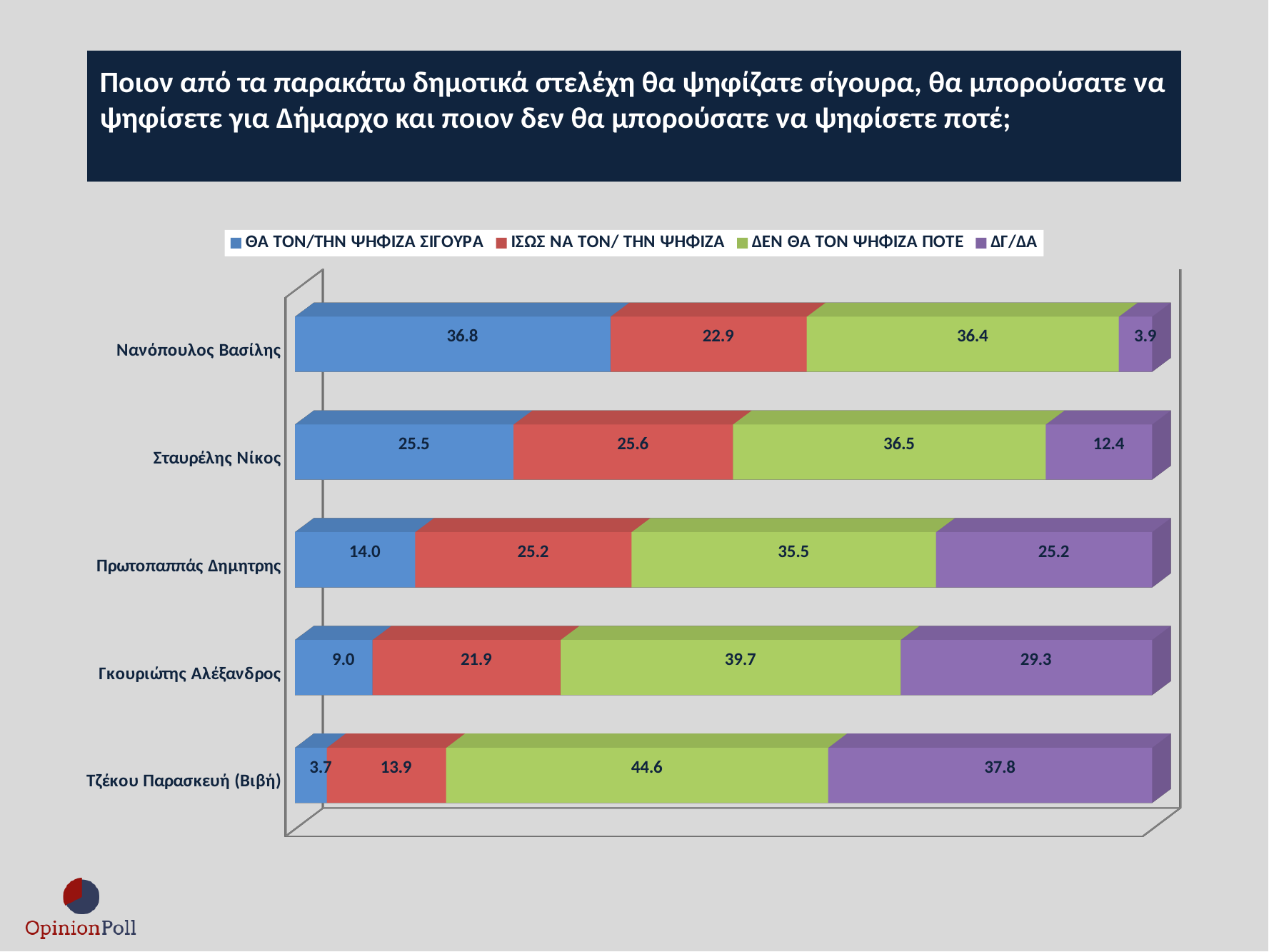
Who has the larger ΔΓ/ΔΑ value, Γκουριώτης Αλέξανδρος or Πρωτοπαππάς Δημήτρης? Γκουριώτης Αλέξανδρος What is the total of the stacked bar for Σταυρέλης Νίκος? 100.0 What is the value of ΘΑ ΤΟΝ/ΤΗΝ ΨΗΦΙΖΑ ΣΙΓΟΥΡΑ for Νανόπουλος Βασίλης? 36.8 Which candidate has the highest ΔΕΝ ΘΑ ΤΟΝ ΨΗΦΙΖΑ ΠΟΤΕ value? Τζέκου Παρασκευή (Βιβή) Which candidate has the lowest ΔΓ/ΔΑ value? Νανόπουλος Βασίλης What is the ΔΓ/ΔΑ value for Τζέκου Παρασκευή (Βιβή)? 37.8 What type of chart is shown on the slide? Stacked bar chart What is the difference between the ΘΑ ΤΟΝ/ΤΗΝ ΨΗΦΙΖΑ ΣΙΓΟΥΡΑ values of Νανόπουλος Βασίλης and Σταυρέλης Νίκος? 11.3 How many series does the legend list? 4 Which candidate has the highest ΘΑ ΤΟΝ/ΤΗΝ ΨΗΦΙΖΑ ΣΙΓΟΥΡΑ value? Νανόπουλος Βασίλης How many candidates are shown in the chart? 5 What is the ΙΣΩΣ ΝΑ ΤΟΝ/ΤΗΝ ΨΗΦΙΖΑ value for Γκουριώτης Αλέξανδρος? 21.9